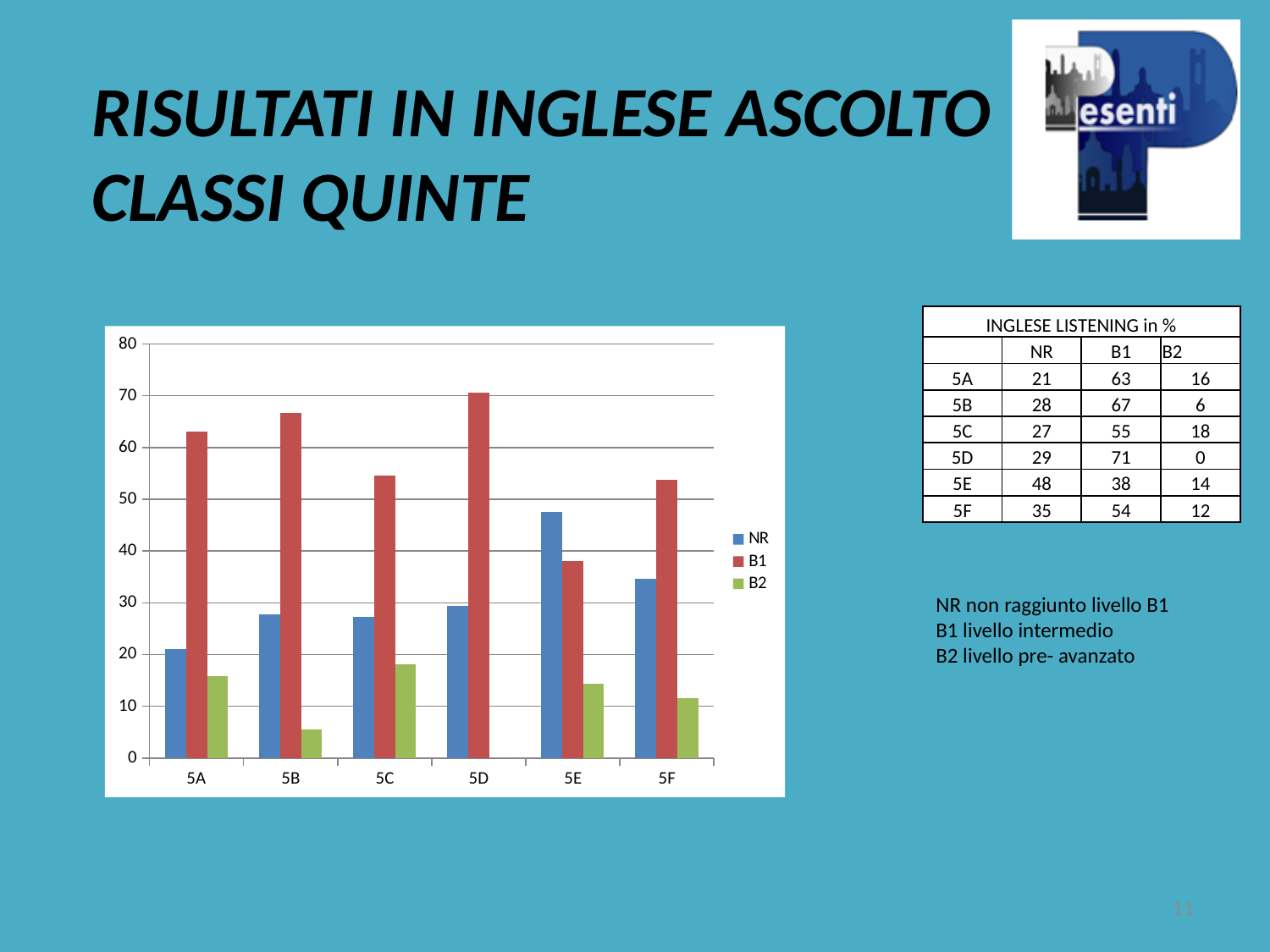
According to the table on the slide, what is the B1 value for 5B? 67 What colour are the B2 bars in the chart? green Is the NR value for 5A greater or less than 30? less Which class has the lowest B2 value? 5D Is the B1 value for 5D greater or less than 70? greater Which is larger for class 5E, the NR value or the B1 value? NR What kind of chart is shown on the slide? bar chart Which class has the highest NR value? 5E Which class has the highest B1 value? 5D How many series does the chart legend list? 3 How many classes are shown on the x axis of the chart? 6 According to the table on the slide, what is the difference between the NR values of 5E and 5A? 27